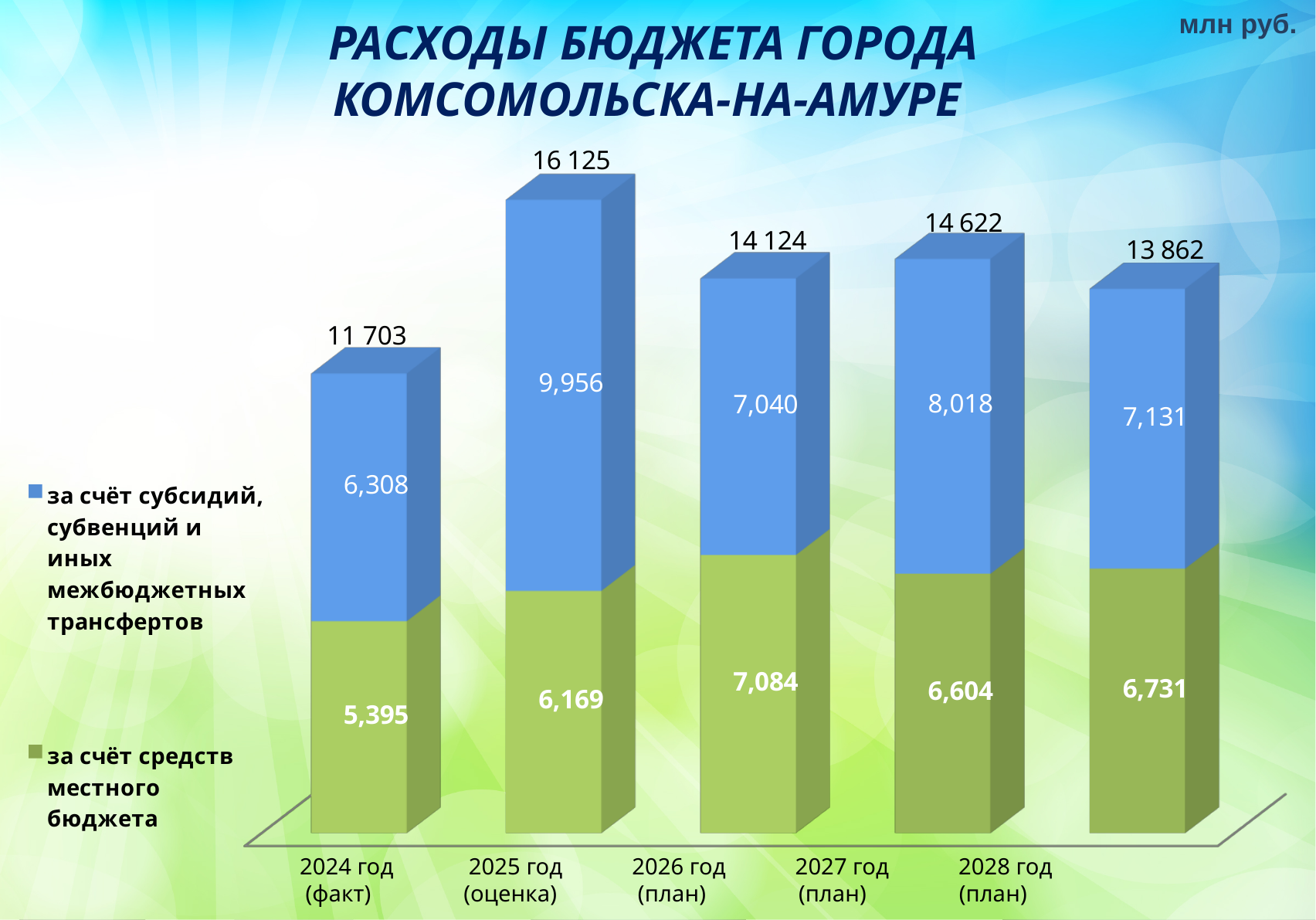
Which year has the largest 'за счёт средств местного бюджета' segment? 2026 год (план) How many years are shown on the x axis? 5 How many series does the legend list? 2 Which is larger: the 'за счёт субсидий, субвенций и иных межбюджетных трансфертов' segment for 2027 год (план) or for 2028 год (план)? 2027 год (план) What kind of chart is shown on the slide? Stacked bar chart What is the value of the 'за счёт субсидий, субвенций и иных межбюджетных трансфертов' segment for 2024 год (факт)? 6,308 What is the total budget expenditure shown for 2025 год (оценка)? 16 125 Which year has the highest total budget expenditure? 2025 год (оценка) What is the value of the 'за счёт субсидий, субвенций и иных межбюджетных трансфертов' segment for 2028 год (план)? 7,131 Which year has the lowest total budget expenditure? 2024 год (факт) What is the difference between the total for 2027 год (план) and the total for 2026 год (план)? 498 What is the value of the 'за счёт средств местного бюджета' segment for 2026 год (план)? 7,084